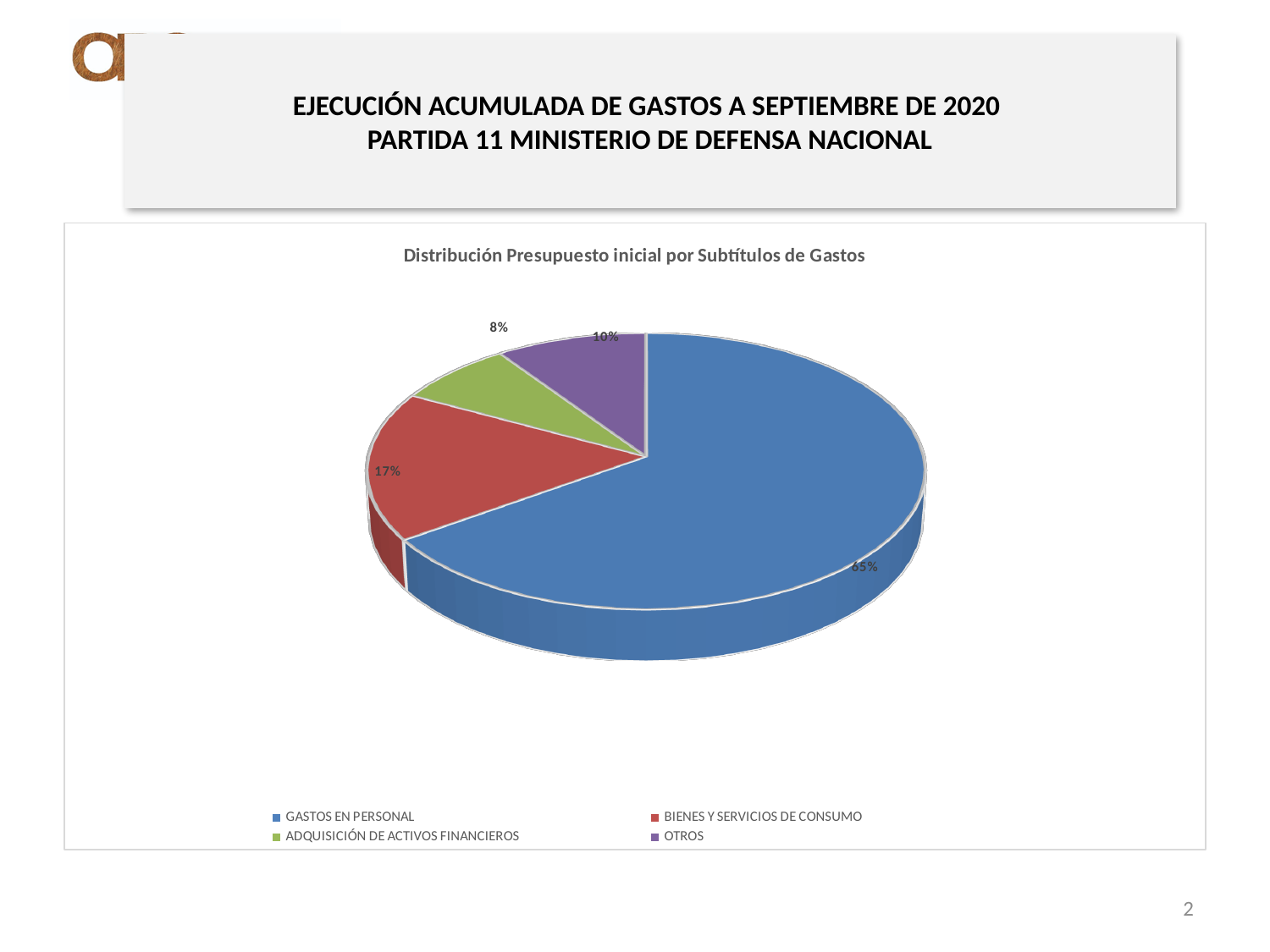
Which is larger, the share for OTROS or the share for ADQUISICIÓN DE ACTIVOS FINANCIEROS? OTROS How many categories does the pie chart show? 4 What is the difference in percentage points between GASTOS EN PERSONAL and BIENES Y SERVICIOS DE CONSUMO? 48 What type of chart is shown on the slide? Pie chart Which category has the largest slice of the pie? GASTOS EN PERSONAL What is the title of the chart? Distribución Presupuesto inicial por Subtítulos de Gastos What colour is the slice for BIENES Y SERVICIOS DE CONSUMO? Red What share of the pie does BIENES Y SERVICIOS DE CONSUMO represent? 17% What share of the pie does OTROS represent? 10% What share of the pie does GASTOS EN PERSONAL represent? 65% Which category has the smallest slice of the pie? ADQUISICIÓN DE ACTIVOS FINANCIEROS